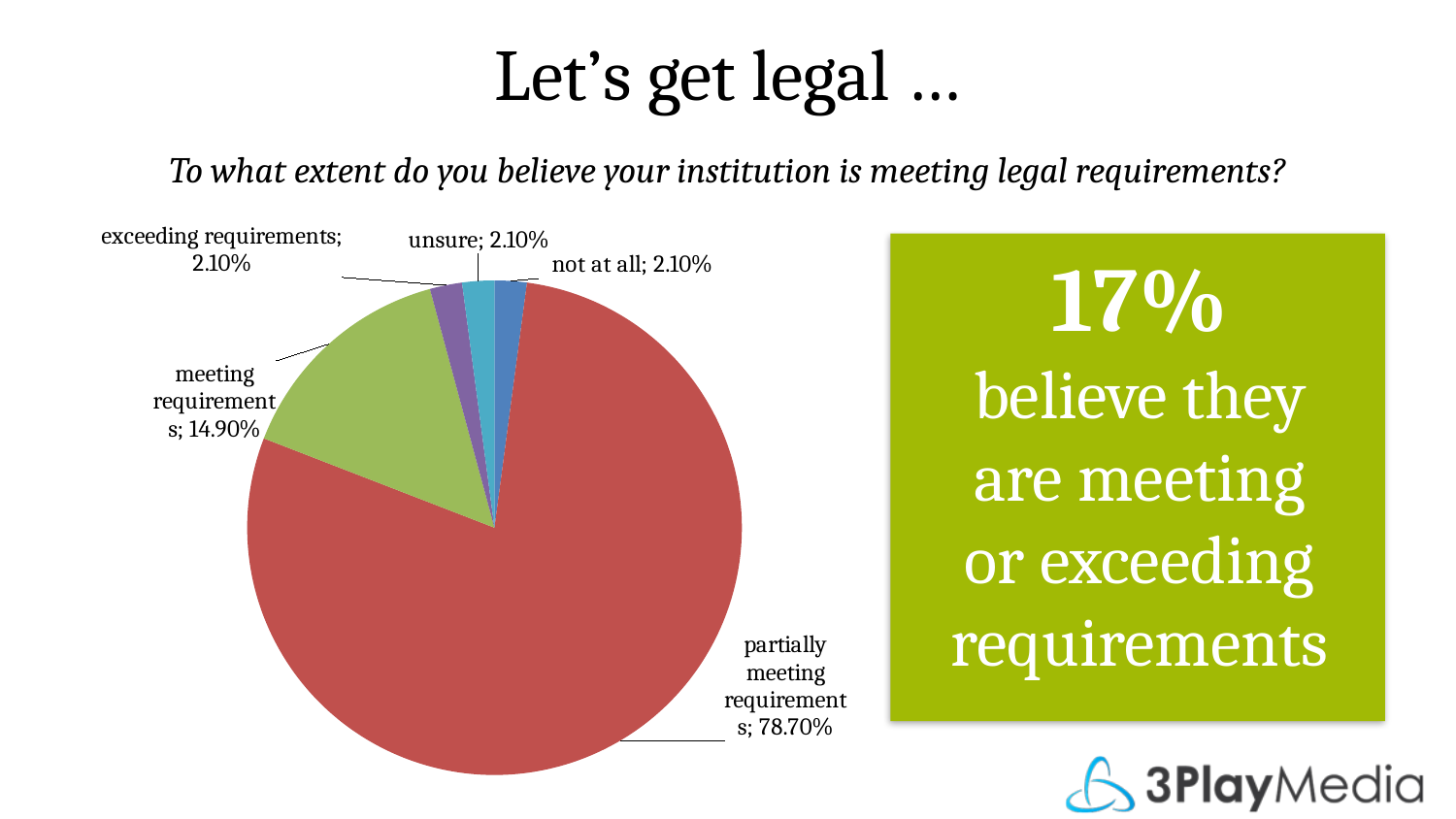
What percentage of respondents said their institution is partially meeting requirements? 78.70% What is the difference between the share for partially meeting requirements and the share for meeting requirements? 63.80% What is the combined share of meeting requirements and exceeding requirements? 17.00% Which category has the largest share of the pie? partially meeting requirements What kind of chart is shown on the slide? pie chart How many slices does the pie chart have? 5 What percentage of respondents were unsure? 2.10% What percentage of respondents said their institution is meeting requirements? 14.90% Which is larger: the share for meeting requirements or the share for not at all? meeting requirements What percentage of respondents said their institution is exceeding requirements? 2.10% What question does the chart's subtitle say respondents were asked? To what extent do you believe your institution is meeting legal requirements? What colour is the slice for partially meeting requirements? red